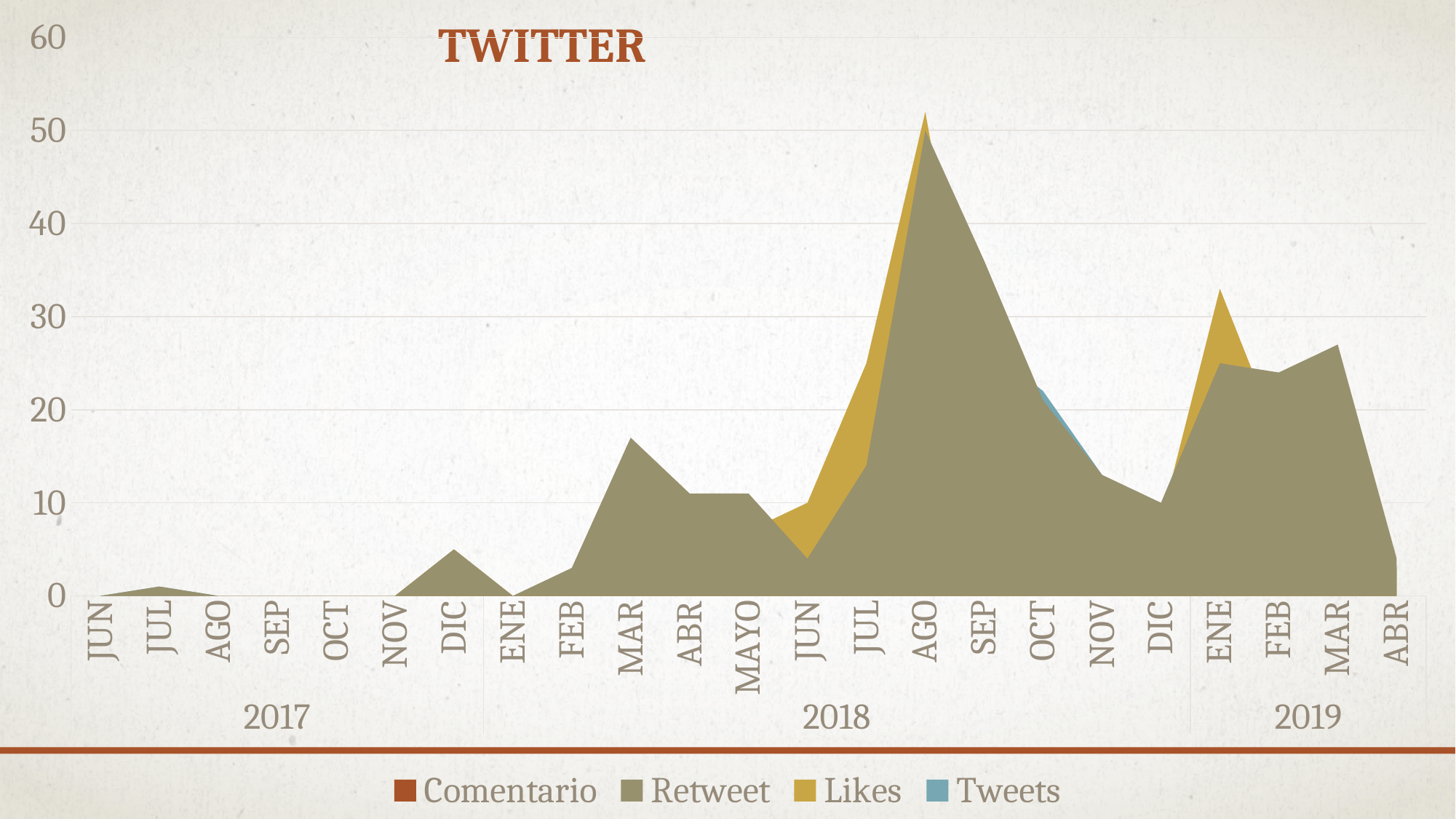
Do the Retweet values rise or fall from AGO 2018 to DIC 2018? fall How many series does the legend list? 4 In which month does the chart reach its highest value? AGO 2018 What type of chart is shown on the slide? Area chart Is the Retweet value for MAR 2018 greater or less than 10? greater What is the title of the chart? TWITTER Which series is shown in yellow in the legend? Likes Is the Retweet value for DIC 2018 greater or less than 20? less Do the Retweet values rise or fall from JUN 2018 to AGO 2018? rise Is the Retweet value for AGO 2018 greater or less than 40? greater How many months are plotted along the x axis? 23